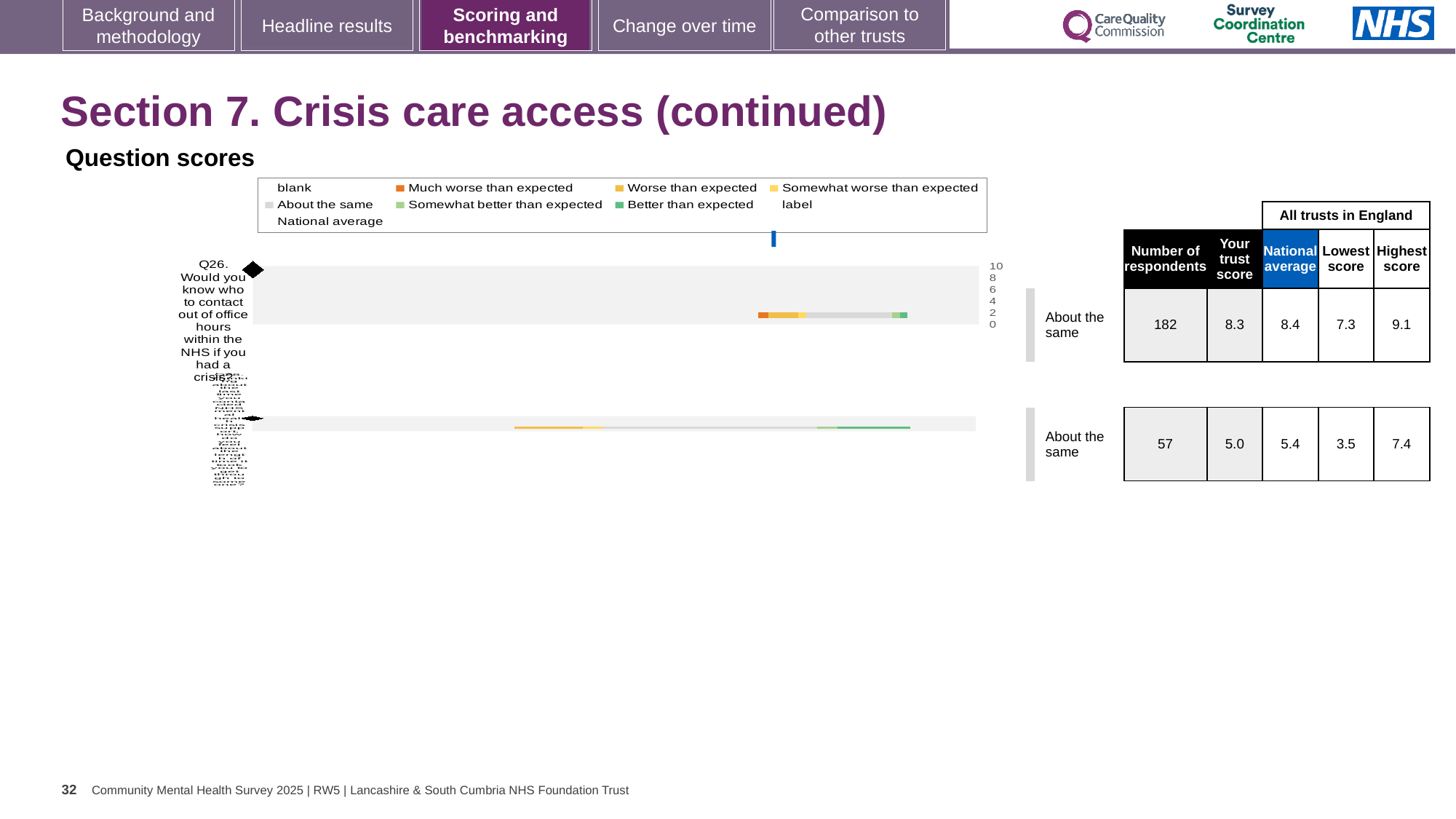
What is the highest value shown on the chart's score axis? 10 What is the highest score among all trusts in England for Q26? 9.1 How many question rows are plotted in the question scores chart? 2 Is the trust score for Q26 higher or lower than the national average? lower What is the lowest score among all trusts in England for Q26? 7.3 What kind of chart is used to show the question scores on this slide? bar chart How is the trust's Q26 score categorised relative to expectations? About the same Which colour in the legend represents 'Much worse than expected'? orange What is the trust score for Q26 (Would you know who to contact out of office hours within the NHS if you had a crisis?)? 8.3 What is the difference between the highest and lowest trust scores in England for Q26? 1.8 What is the national average score for Q26? 8.4 How many respondents answered Q26? 182